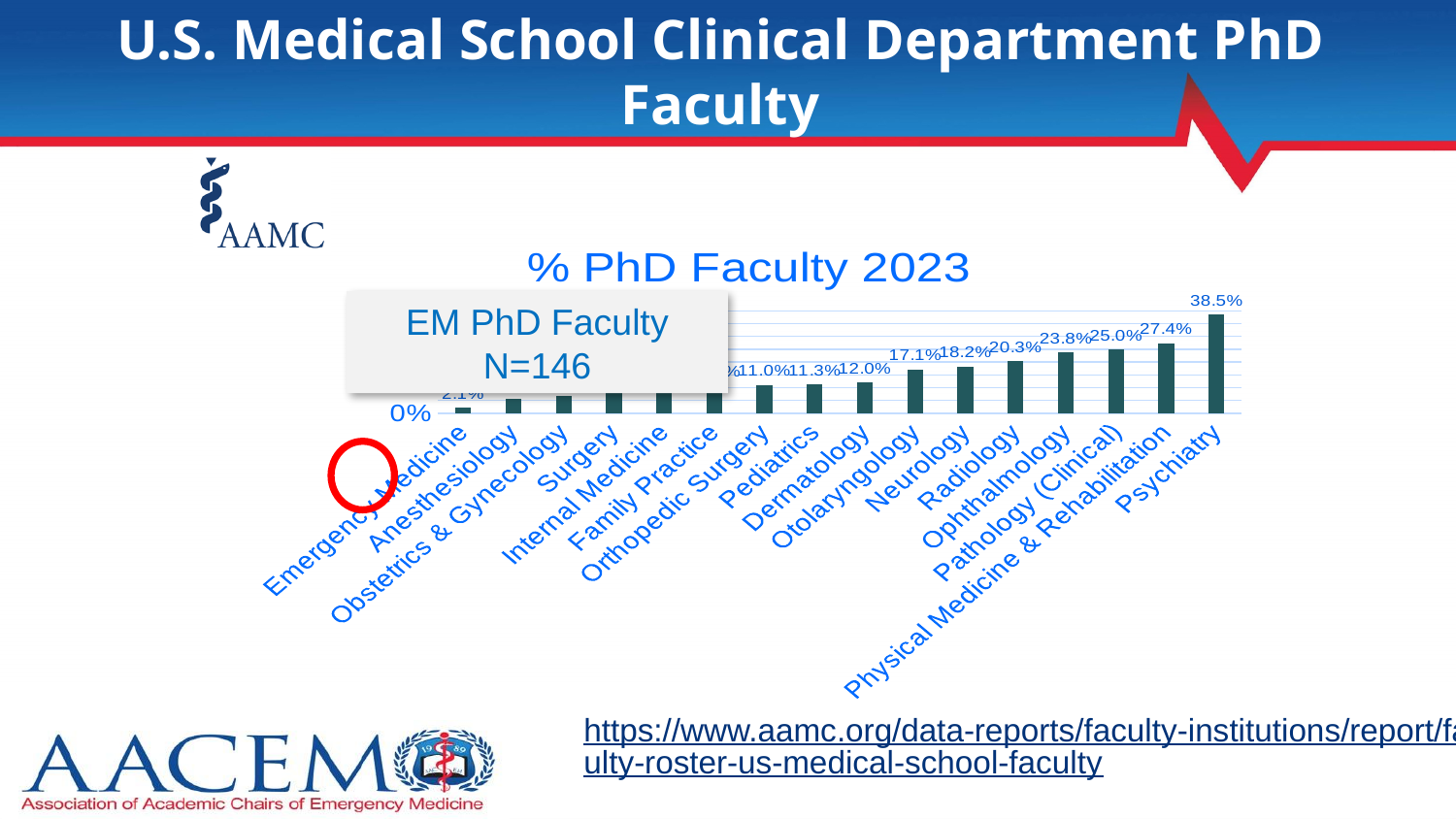
What is the % PhD faculty value for Psychiatry? 38.5% What is the % PhD faculty value for Physical Medicine & Rehabilitation? 27.4% Do the bar values rise or fall from left to right along the x axis? rise What is the difference between the % PhD faculty values for Psychiatry and Physical Medicine & Rehabilitation? 11.1% Which department has the highest % PhD faculty in the chart? Psychiatry How many departments are shown on the x axis of the chart? 16 What is the % PhD faculty value for Emergency Medicine? 2.1% What is the % PhD faculty value for Pathology (Clinical)? 25.0% Which department has the lowest % PhD faculty in the chart? Emergency Medicine What is the title of the chart? % PhD Faculty 2023 What kind of chart is shown on the slide? bar chart Which has a higher % PhD faculty value, Radiology or Neurology? Radiology